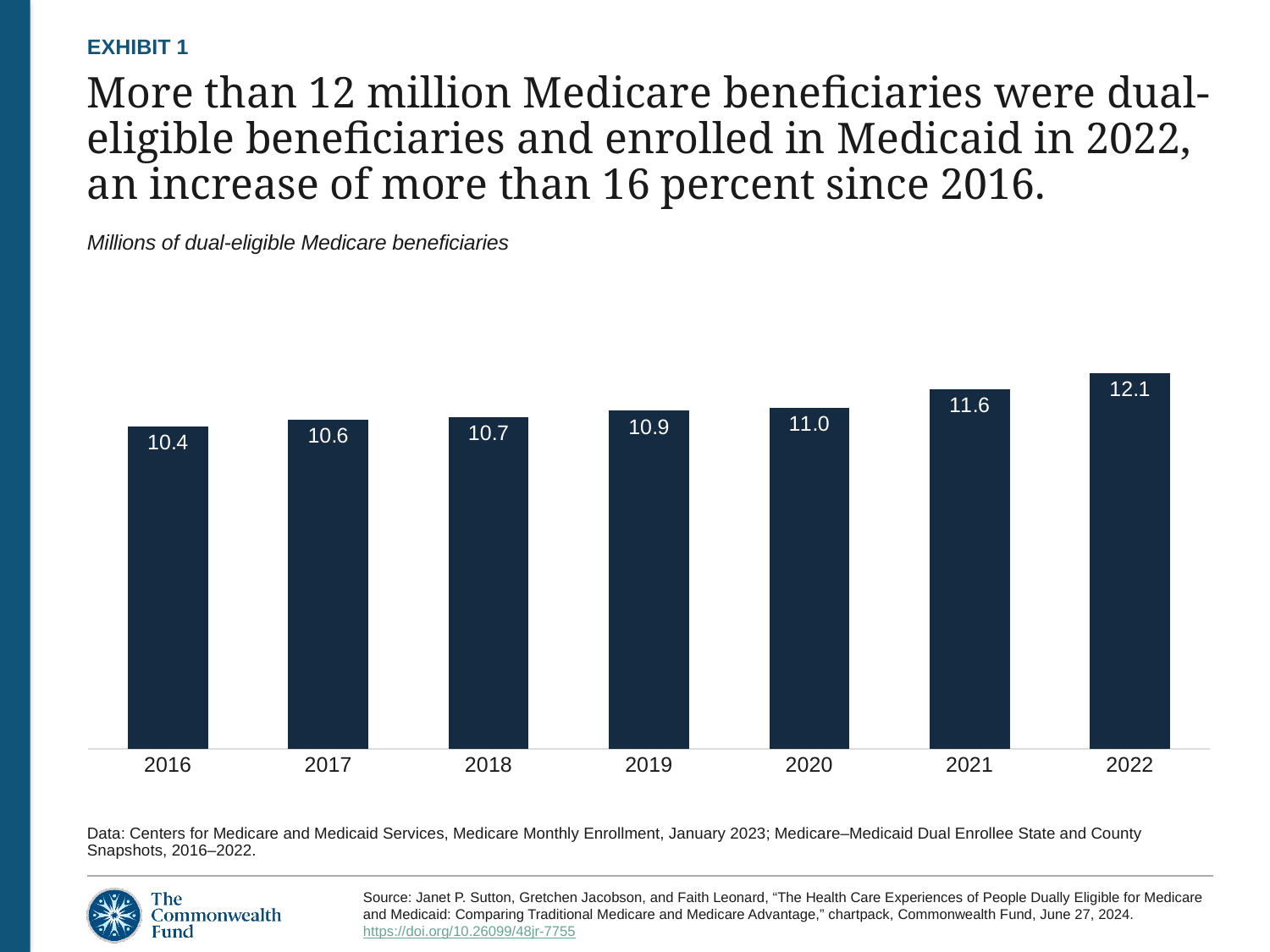
What is the value for 2019? 10.9 What is the difference between the values for 2021 and 2020? 0.6 What is the value for 2022? 12.1 What is the difference between the values for 2022 and 2016? 1.7 Which is larger, the value for 2018 or the value for 2021? 2021 What is the value for 2016? 10.4 What kind of chart is shown on the slide? bar chart Do the values rise or fall from 2016 to 2022? rise What unit does the chart subtitle say the values are in? Millions of dual-eligible Medicare beneficiaries Which year has the highest value? 2022 Which year has the lowest value? 2016 How many years are shown on the chart? 7